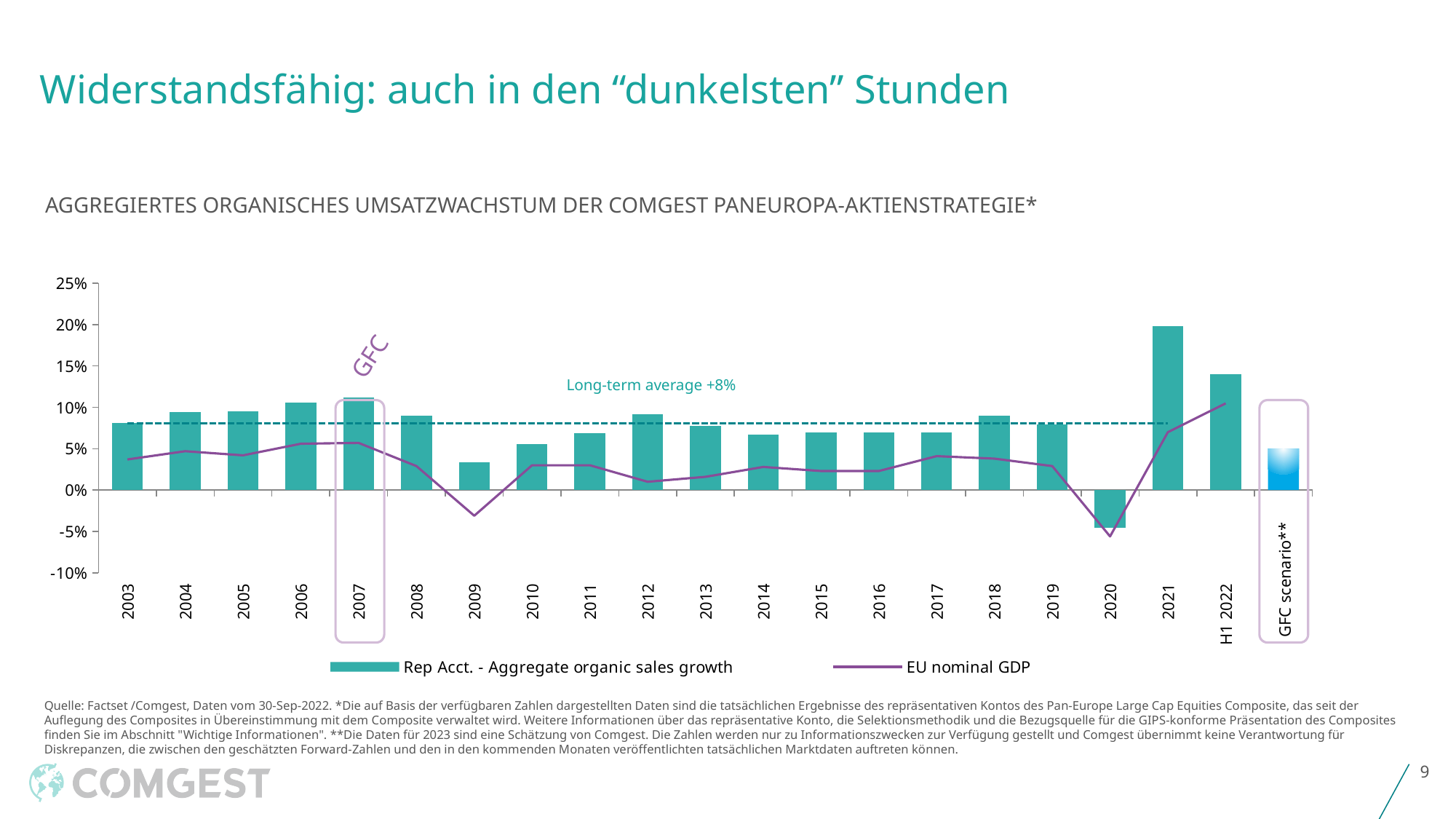
Is the organic sales growth bar for 2021 greater or less than 15%? greater Which category has the lowest bar for Rep Acct. - Aggregate organic sales growth? 2020 Which bar is taller, 2006 or 2009? 2006 Does the EU nominal GDP line rise or fall from 2019 to 2020? fall What long-term average value is annotated on the chart? +8% How many series does the legend list? 2 In which year does the EU nominal GDP line reach its lowest point? 2020 Is the organic sales growth bar for 2009 greater or less than 5%? less Which category has the highest bar for Rep Acct. - Aggregate organic sales growth? 2021 What is the legend label of the line series? EU nominal GDP Is the organic sales growth bar for H1 2022 greater or less than 10%? greater What kind of chart is shown on the slide? bar chart with a line overlay